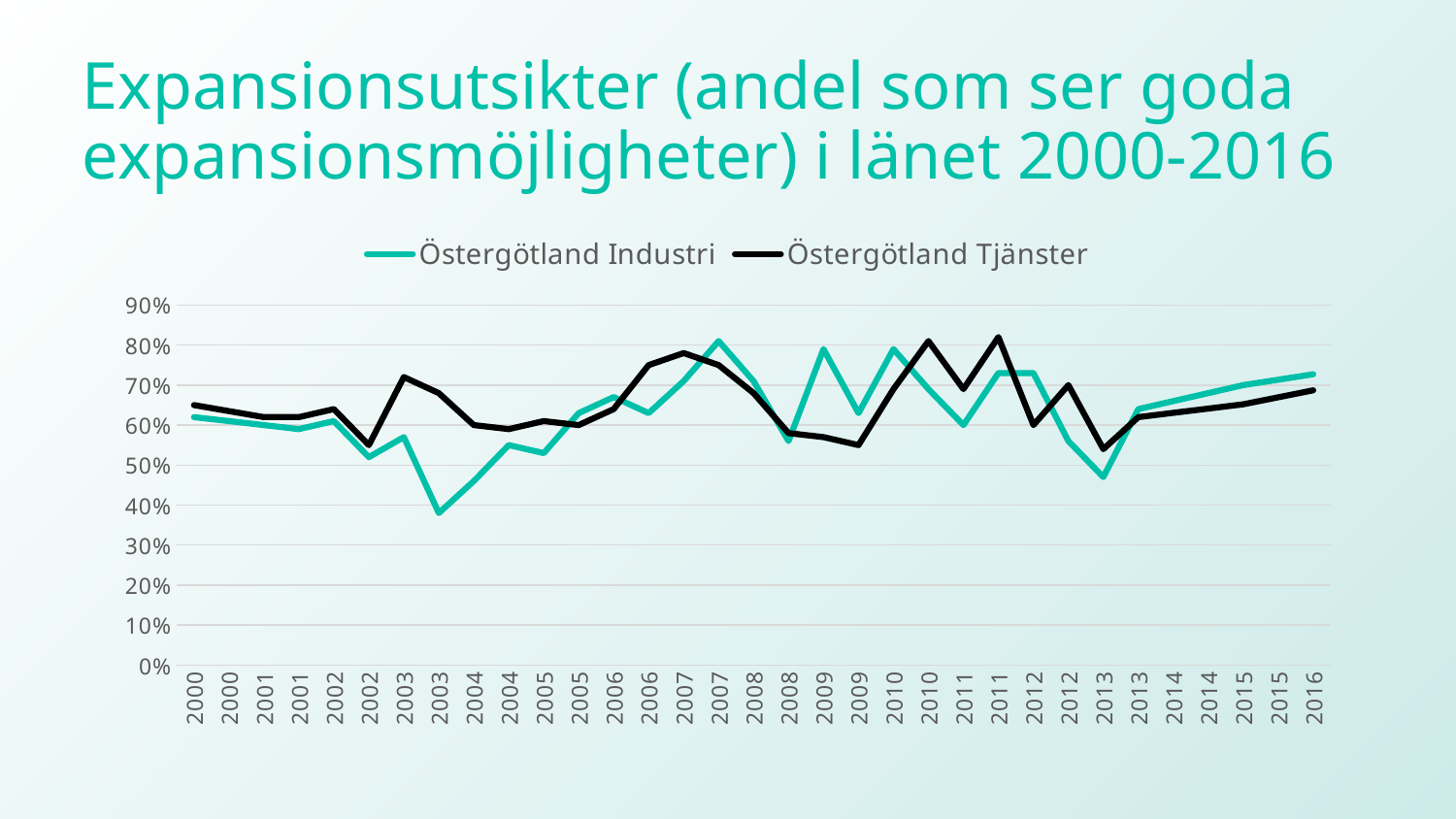
Which colour is used for the Östergötland Tjänster line? Black How many series does the legend list? 2 At which year does the Östergötland Industri line reach its lowest point? 2003 What is the highest value shown on the y axis? 90% How many data points are plotted along the x axis for each series? 33 From 2013 to 2016, does the Östergötland Industri line rise or fall? Rise What kind of chart is shown on the slide? Line chart Is the lowest value of Östergötland Industri (in 2003) greater or less than 50%? less Is the value for Östergötland Tjänster at its 2011 peak greater or less than 80%? greater At the second 2003 point, which series has the larger value, Östergötland Industri or Östergötland Tjänster? Östergötland Tjänster At the first 2009 point, which series has the larger value, Östergötland Industri or Östergötland Tjänster? Östergötland Industri What are the two series named in the legend? Östergötland Industri and Östergötland Tjänster